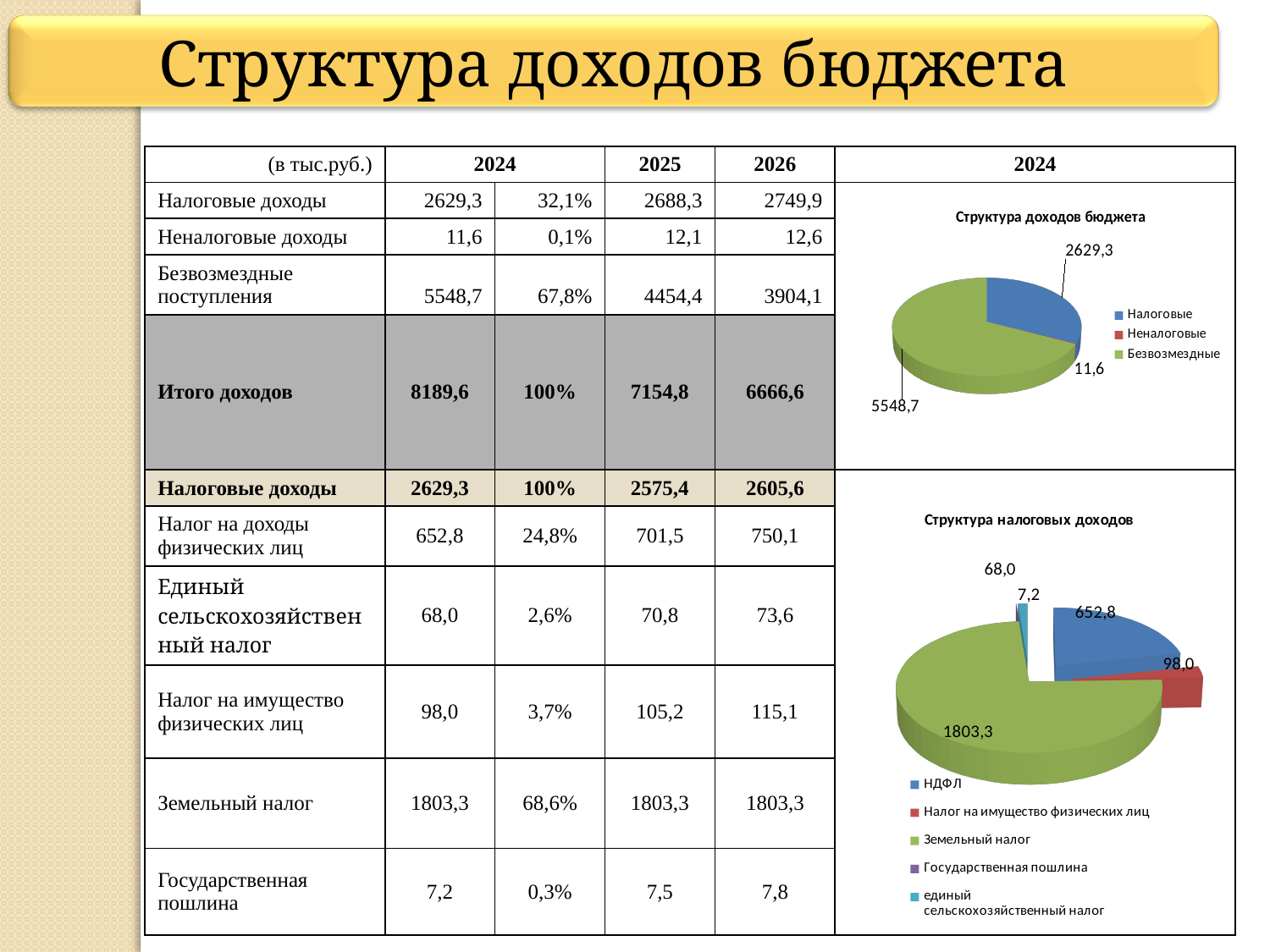
In the bottom chart "Структура налоговых доходов", how many categories does the legend list? 5 In the bottom chart "Структура налоговых доходов", what is the difference between НДФЛ (652,8) and Налог на имущество физических лиц (98,0)? 554,8 In the bottom chart "Структура налоговых доходов", what is the value for Земельный налог? 1803,3 In the top chart "Структура доходов бюджета", which category has the largest slice? Безвозмездные In the top chart "Структура доходов бюджета", which category has the smallest slice? Неналоговые In the bottom chart "Структура налоговых доходов", which is larger: НДФЛ or Налог на имущество физических лиц? НДФЛ In the top chart "Структура доходов бюджета", what is the value for Налоговые? 2629,3 In the top chart "Структура доходов бюджета", what is the value for Безвозмездные? 5548,7 In the bottom chart "Структура налоговых доходов", what is the value for Государственная пошлина? 7,2 In the top chart "Структура доходов бюджета", how many categories does the legend list? 3 In the bottom chart "Структура налоговых доходов", which category has the largest slice? Земельный налог What kind of chart is the top chart titled "Структура доходов бюджета"? pie chart